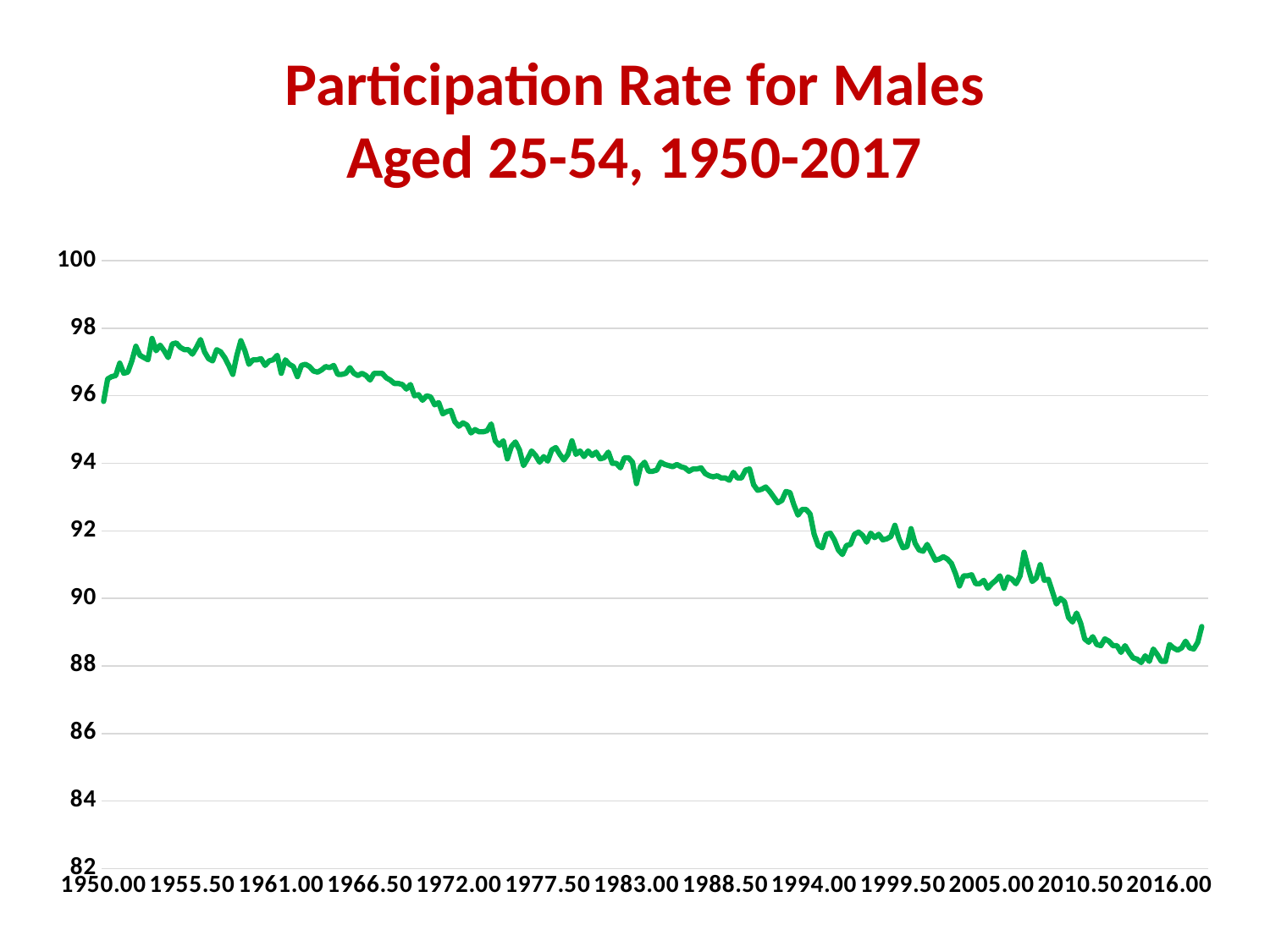
Is the value for 1994.00 greater or less than 94? less Is the value for 1955.50 greater or less than 96? greater Is the value for 1977.50 greater or less than 92? greater Overall, does the participation rate rise or fall from 1950 to 2017? fall Is the participation rate higher in 1961.00 or in 2010.50? 1961.00 What is the title of the chart? Participation Rate for Males Aged 25-54, 1950-2017 What is the lowest value shown on the vertical axis? 82 In which decade does the line reach its highest values? 1950s What kind of chart is shown on the slide? line chart